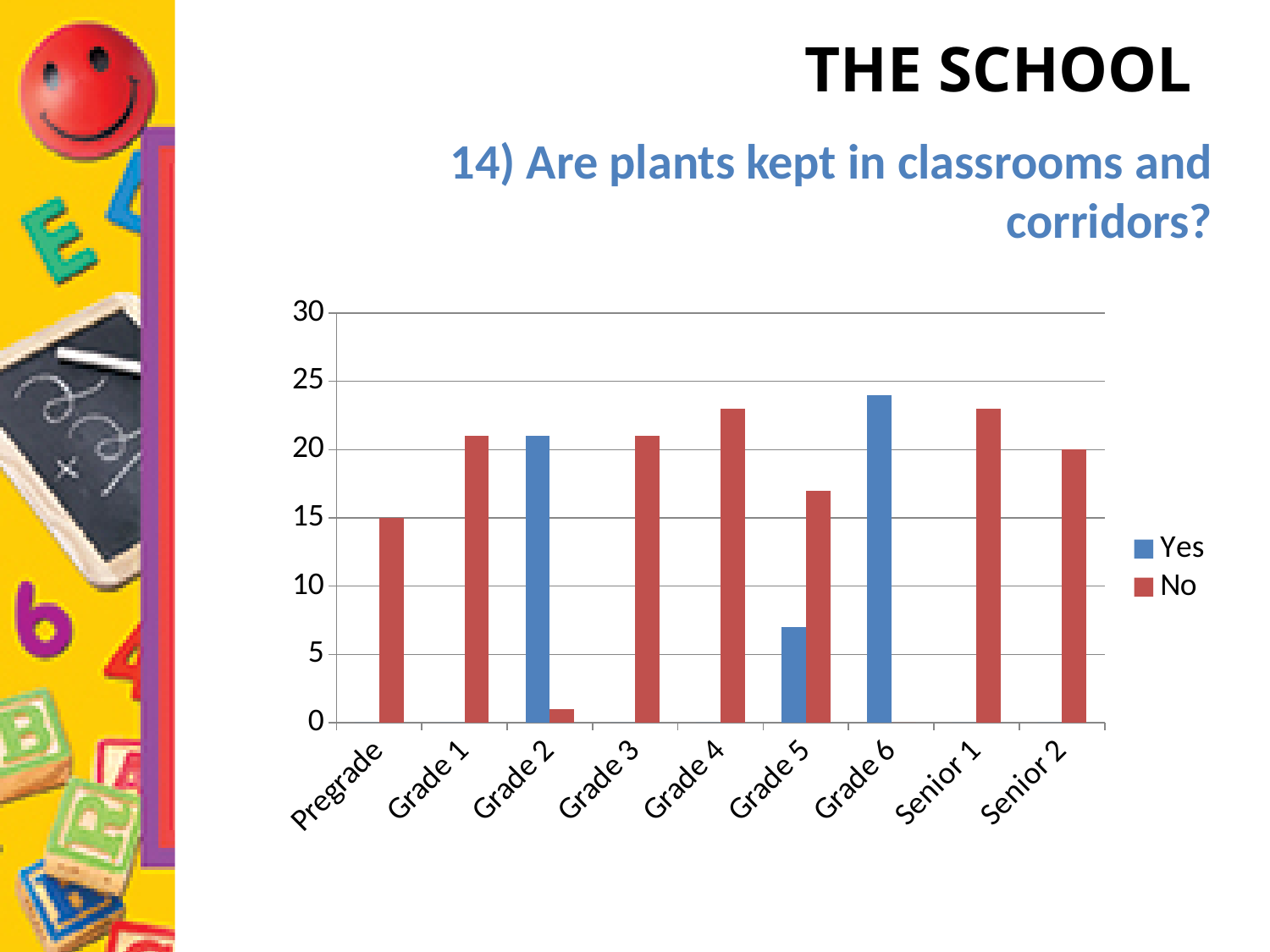
Is the 'Yes' value for Grade 6 greater or less than 20? greater Is the 'Yes' value for Grade 5 greater or less than 10? less How many grade categories are shown on the x axis? 9 Which category has the lowest 'No' value? Grade 6 What are the two legend entries? Yes and No How many series does the legend list? 2 Is the 'No' value for Grade 4 greater or less than 20? greater Which colour represents the 'No' series? red For Grade 5, which is larger, the 'Yes' value or the 'No' value? No What kind of chart is shown on the slide? bar chart Which category has the highest 'Yes' value? Grade 6